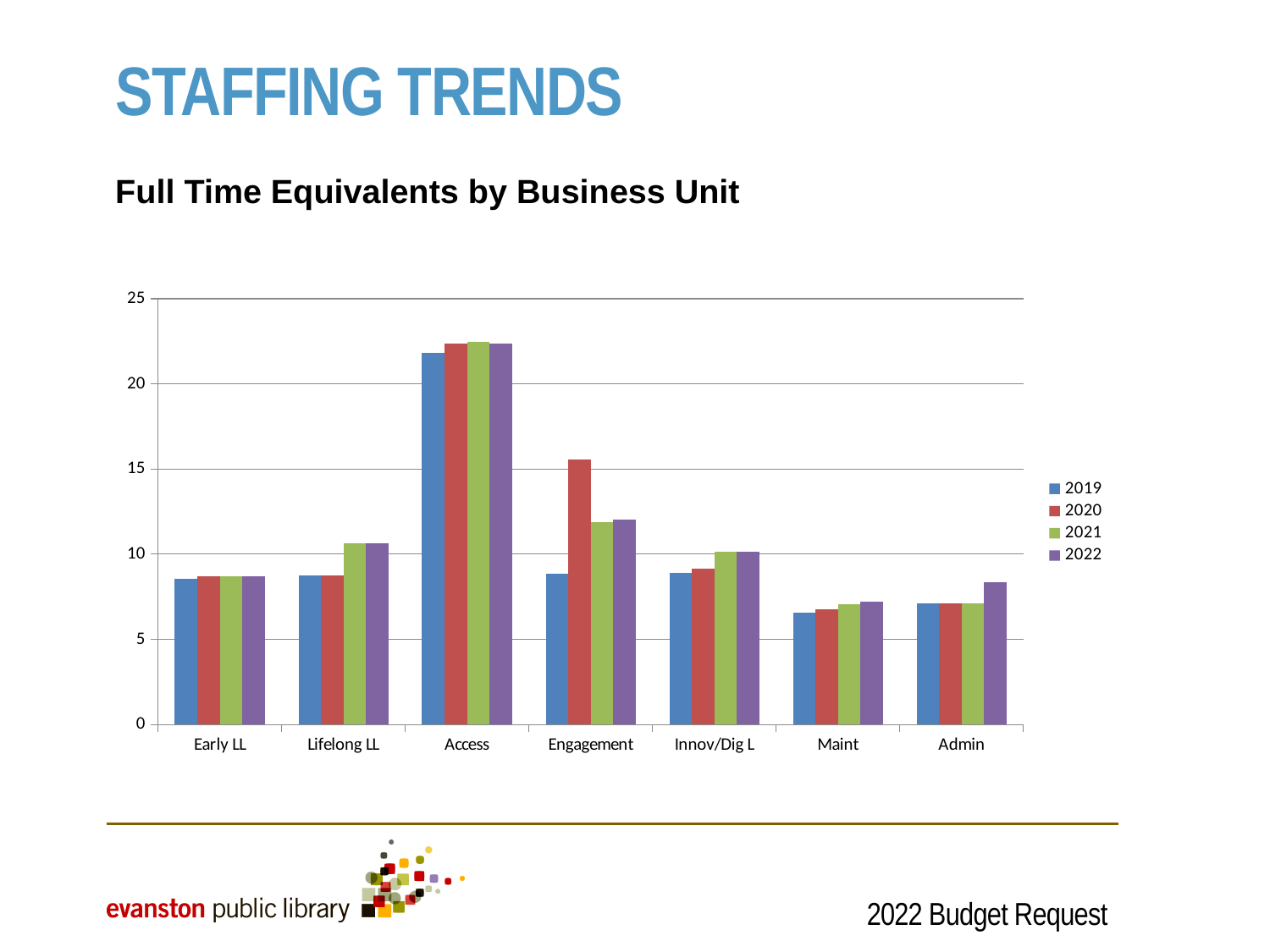
What are the entries listed in the chart legend? 2019, 2020, 2021, 2022 How many business units are shown on the x axis? 7 For Lifelong LL, which is larger: the 2019 value or the 2021 value? 2021 For Engagement, which is larger: the 2020 value or the 2021 value? 2020 Is the 2021 value for Access greater or less than 20? greater Which business unit has the highest value for 2022? Access For Engagement, which year has the highest value? 2020 What kind of chart is shown on the slide? bar chart Is the 2019 value for Maint greater or less than 10? less How many series does the legend list? 4 Is the 2020 value for Engagement greater or less than 10? greater Which business unit has the lowest value for 2019? Maint